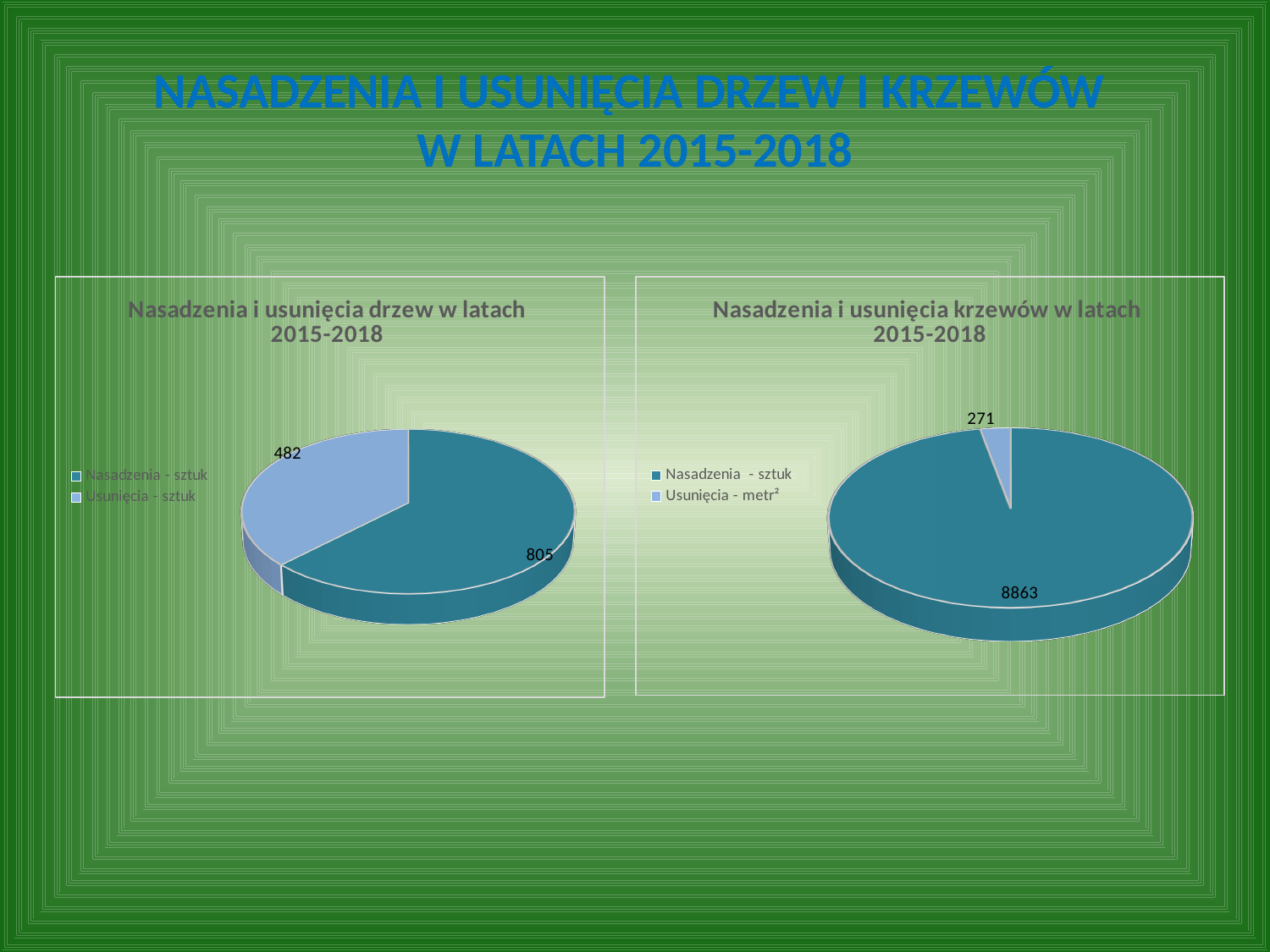
In the right chart (Nasadzenia i usunięcia krzewów w latach 2015-2018), what is the difference between Nasadzenia - sztuk and Usunięcia - metr²? 8592 In the right chart (Nasadzenia i usunięcia krzewów w latach 2015-2018), which slice is the smallest? Usunięcia - metr² How many entries does the legend of the right chart (Nasadzenia i usunięcia krzewów w latach 2015-2018) list? 2 In the right chart (Nasadzenia i usunięcia krzewów w latach 2015-2018), what is the value for Nasadzenia - sztuk? 8863 In the left chart (Nasadzenia i usunięcia drzew w latach 2015-2018), which slice is larger, Nasadzenia - sztuk or Usunięcia - sztuk? Nasadzenia - sztuk What type of chart is used on the left side of the slide? Pie chart In the right chart (Nasadzenia i usunięcia krzewów w latach 2015-2018), what is the total of the two slices? 9134 In the left chart (Nasadzenia i usunięcia drzew w latach 2015-2018), what is the value for Nasadzenia - sztuk? 805 In the right chart (Nasadzenia i usunięcia krzewów w latach 2015-2018), what share of the pie does Nasadzenia - sztuk represent, to the nearest whole percent? 97% In the left chart (Nasadzenia i usunięcia drzew w latach 2015-2018), what is the value for Usunięcia - sztuk? 482 In the right chart (Nasadzenia i usunięcia krzewów w latach 2015-2018), what is the value for Usunięcia - metr²? 271 In the left chart (Nasadzenia i usunięcia drzew w latach 2015-2018), what is the difference between Nasadzenia - sztuk and Usunięcia - sztuk? 323